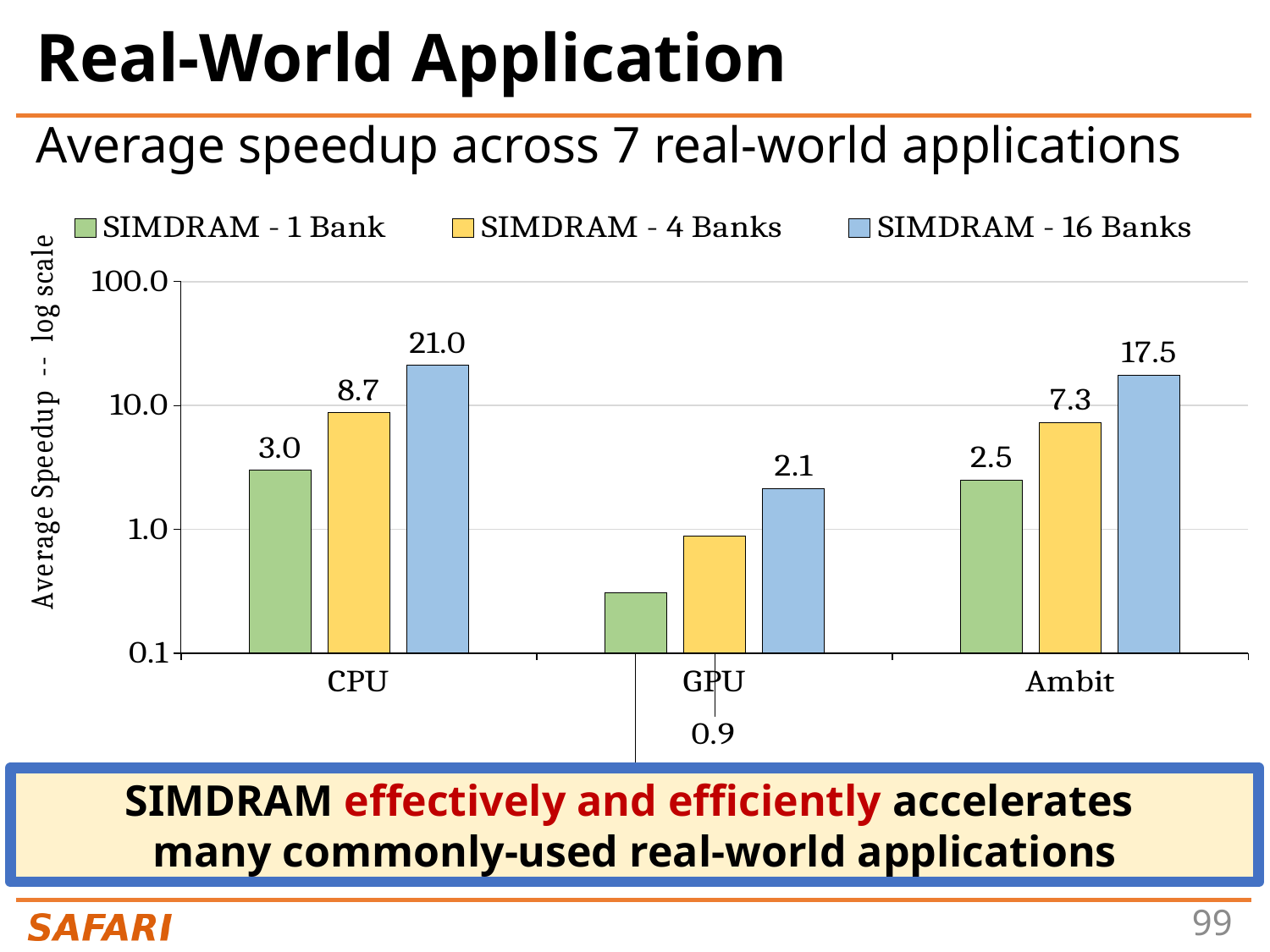
What is the average speedup for SIMDRAM - 4 Banks on Ambit? 7.3 How many categories are shown on the x axis? 3 What kind of chart is shown on the slide? bar chart Which category has the lowest value for SIMDRAM - 1 Bank? GPU What is the average speedup for SIMDRAM - 16 Banks on GPU? 2.1 Is the SIMDRAM - 1 Bank value for GPU greater or less than 1.0? less Which category has the highest value for SIMDRAM - 16 Banks? CPU What is the average speedup for SIMDRAM - 1 Bank on CPU? 3.0 What is the difference between the SIMDRAM - 16 Banks values for CPU and Ambit? 3.5 What is the average speedup for SIMDRAM - 16 Banks on CPU? 21.0 How many series does the legend list? 3 What is the title of the y axis? Average Speedup -- log scale